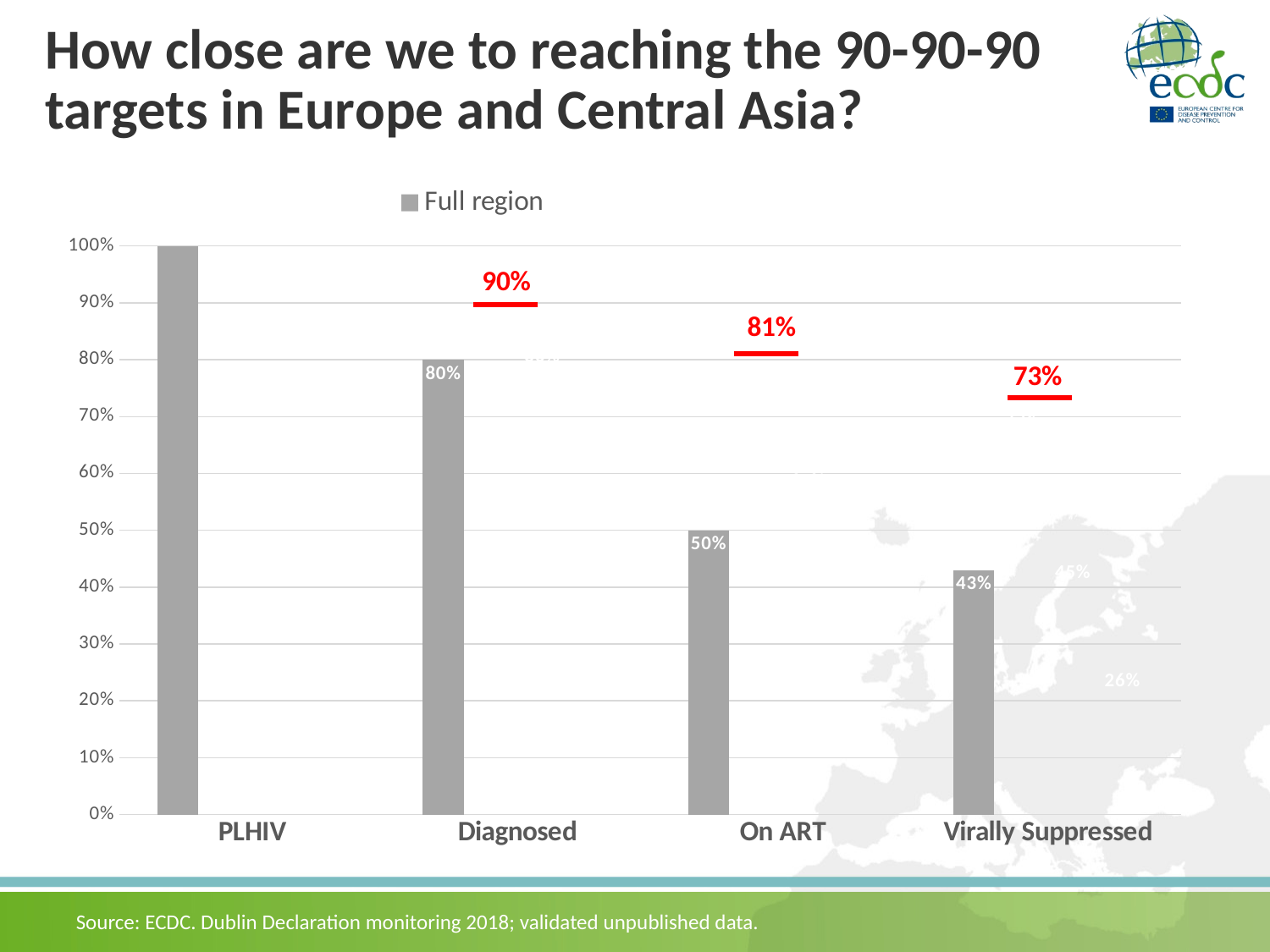
What series name does the legend show? Full region Which is larger, the value for Diagnosed or the value for Virally Suppressed? Diagnosed Is the value for PLHIV greater or less than 90%? greater What is the value for On ART? 50% What kind of chart is shown on the slide? Bar chart Which category has the lowest bar? Virally Suppressed Which category has the highest bar? PLHIV What is the difference between the values for On ART and Virally Suppressed? 7% What is the value for Diagnosed? 80% What is the value for Virally Suppressed? 43% What is the difference between the values for Diagnosed and On ART? 30% How many categories are shown on the x axis? 4